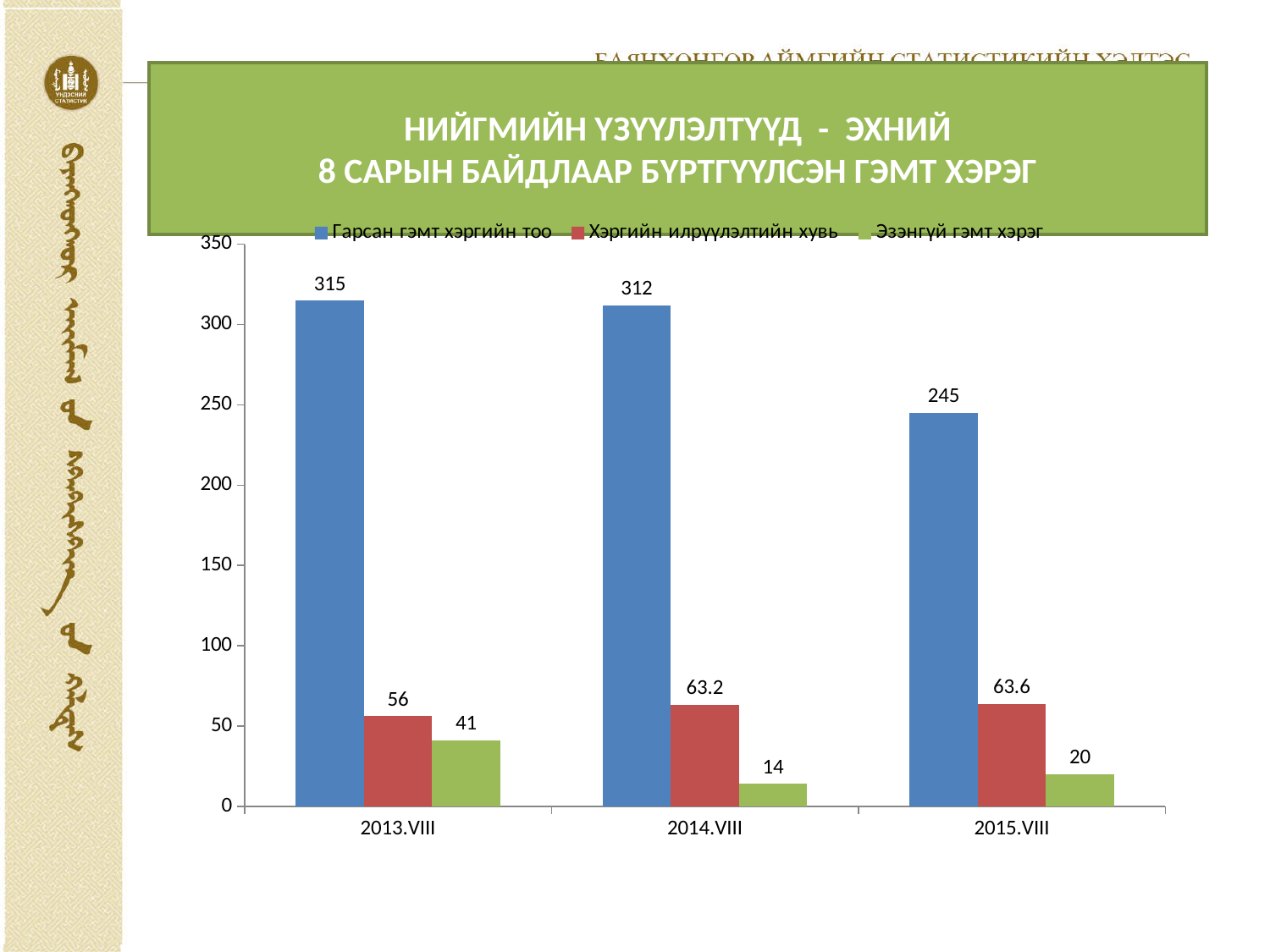
Which period has the lowest value for Гарсан гэмт хэргийн тоо? 2015.VIII How many periods are shown on the x axis? 3 How many series does the legend list? 3 Which is larger: Хэргийн илрүүлэлтийн хувь in 2013.VIII or in 2014.VIII? 2014.VIII What is the difference between Гарсан гэмт хэргийн тоо in 2013.VIII and 2015.VIII? 70 What kind of chart is shown on the slide? Bar chart What is the value of Гарсан гэмт хэргийн тоо for 2013.VIII? 315 What is the value of Хэргийн илрүүлэлтийн хувь for 2015.VIII? 63.6 Which period has the highest value for Эзэнгүй гэмт хэрэг? 2013.VIII Does Гарсан гэмт хэргийн тоо rise or fall from 2013.VIII to 2015.VIII? Fall What is the value of Эзэнгүй гэмт хэрэг for 2014.VIII? 14 Which colour represents Эзэнгүй гэмт хэрэг in the legend? Green